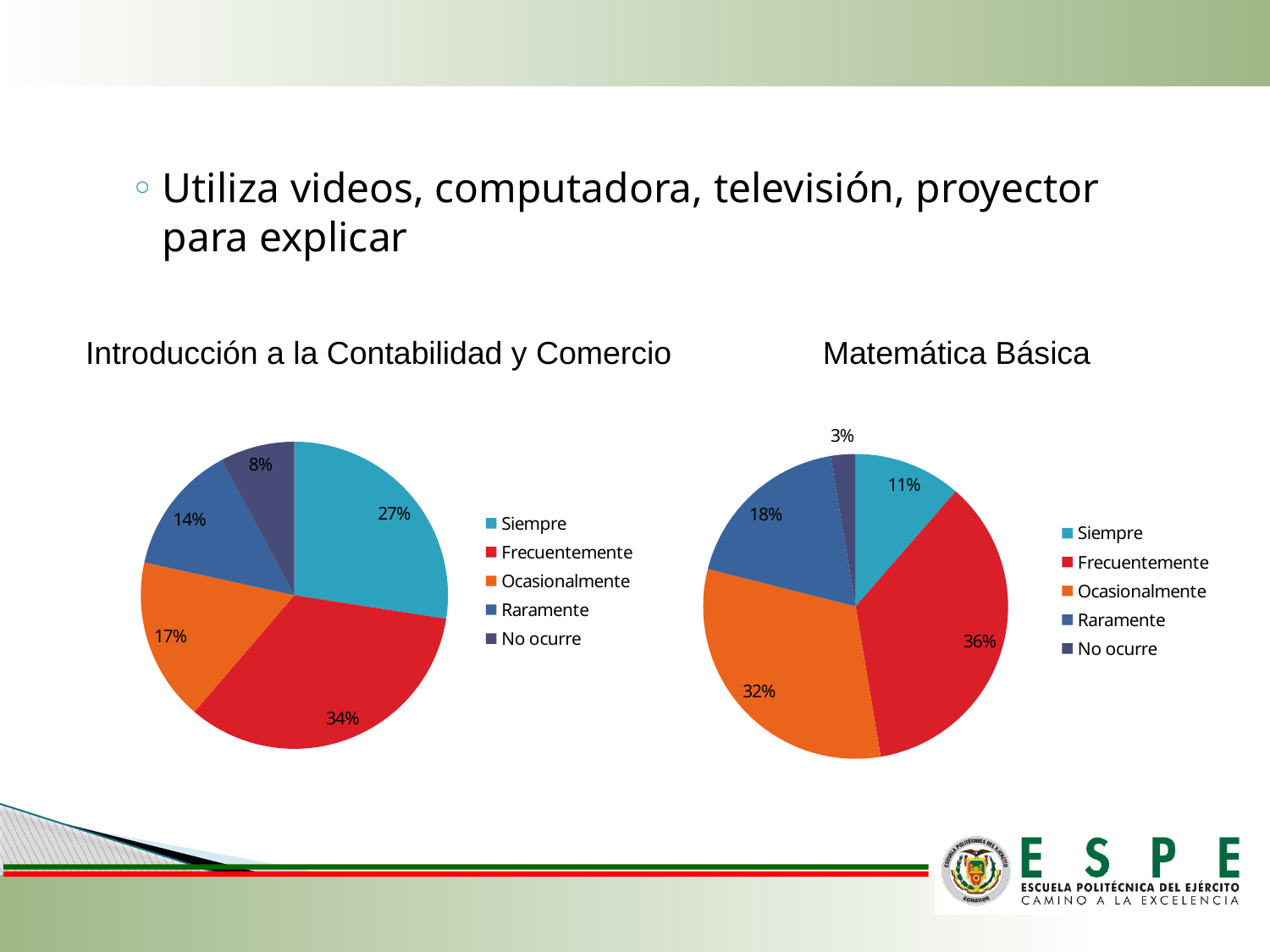
In the 'Matemática Básica' chart, which is larger, Siempre or Raramente? Raramente In the 'Introducción a la Contabilidad y Comercio' chart, what is the difference between the Ocasionalmente and Raramente shares? 3% In the 'Matemática Básica' chart, what share does No ocurre have? 3% In the 'Introducción a la Contabilidad y Comercio' chart, which category has the largest slice? Frecuentemente In the 'Matemática Básica' chart, which category has the largest slice? Frecuentemente In the 'Introducción a la Contabilidad y Comercio' chart, what share does Siempre have? 27% How many categories does the legend of the 'Matemática Básica' chart list? 5 What type of chart is used for 'Introducción a la Contabilidad y Comercio'? Pie chart In the 'Introducción a la Contabilidad y Comercio' chart, which category has the smallest slice? No ocurre In the 'Introducción a la Contabilidad y Comercio' chart, what share does Frecuentemente have? 34% In the 'Matemática Básica' chart, what is the difference between the Frecuentemente and Siempre shares? 25% In the 'Matemática Básica' chart, what share does Ocasionalmente have? 32%